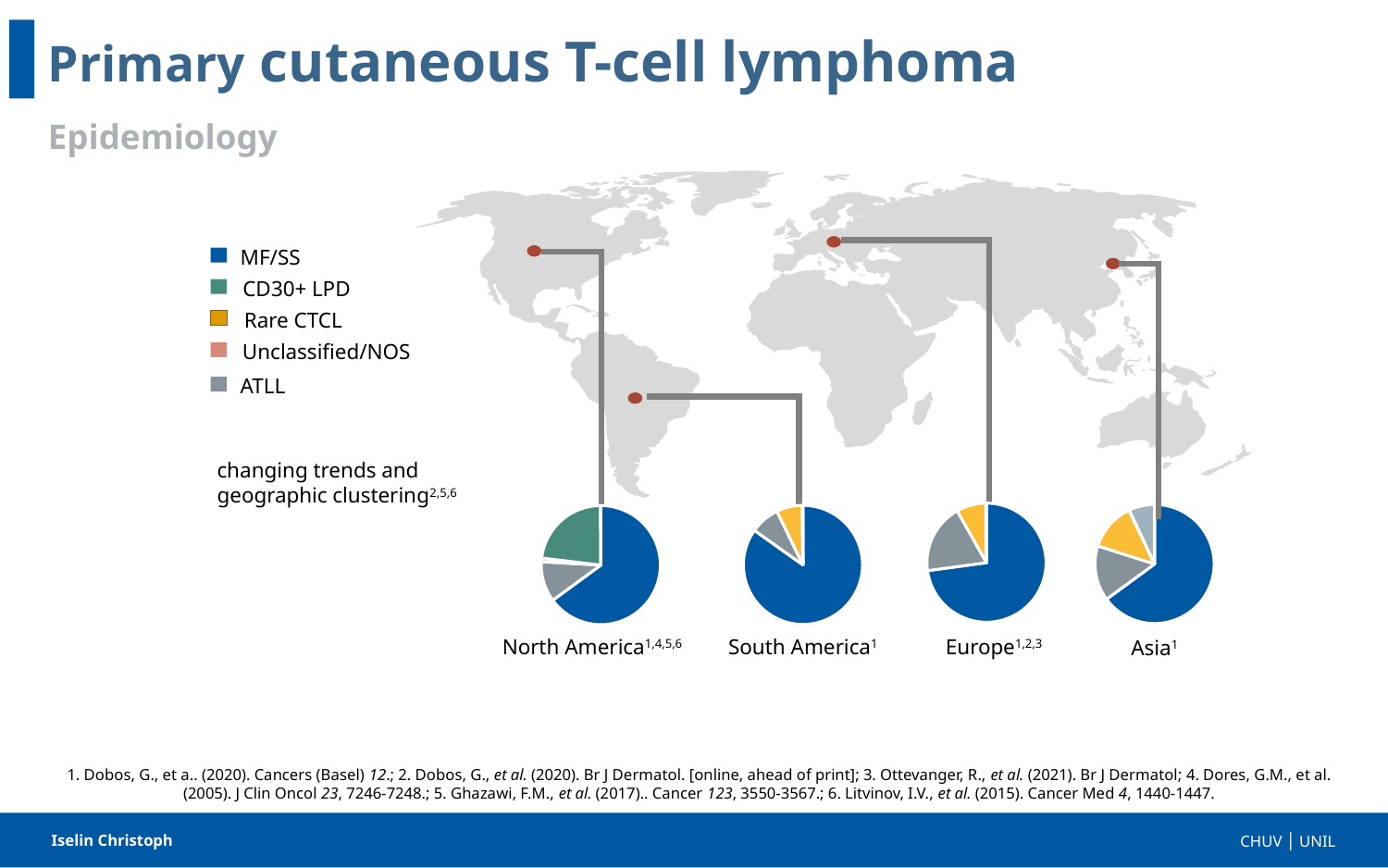
How many slices does the South America pie chart have? 3 In the Asia pie chart, which slice is larger: Rare CTCL or Unclassified/NOS? Rare CTCL How many pie charts are shown on the slide? 4 In the North America pie chart, which category has the largest slice? MF/SS How many categories does the legend list for the pie charts? 5 In the Europe pie chart, which category has the largest slice? MF/SS Which colour represents MF/SS in the legend? Blue What kind of chart is used for North America, South America, Europe and Asia on this slide? Pie chart In the North America pie chart, which slice is larger: CD30+ LPD or ATLL? CD30+ LPD